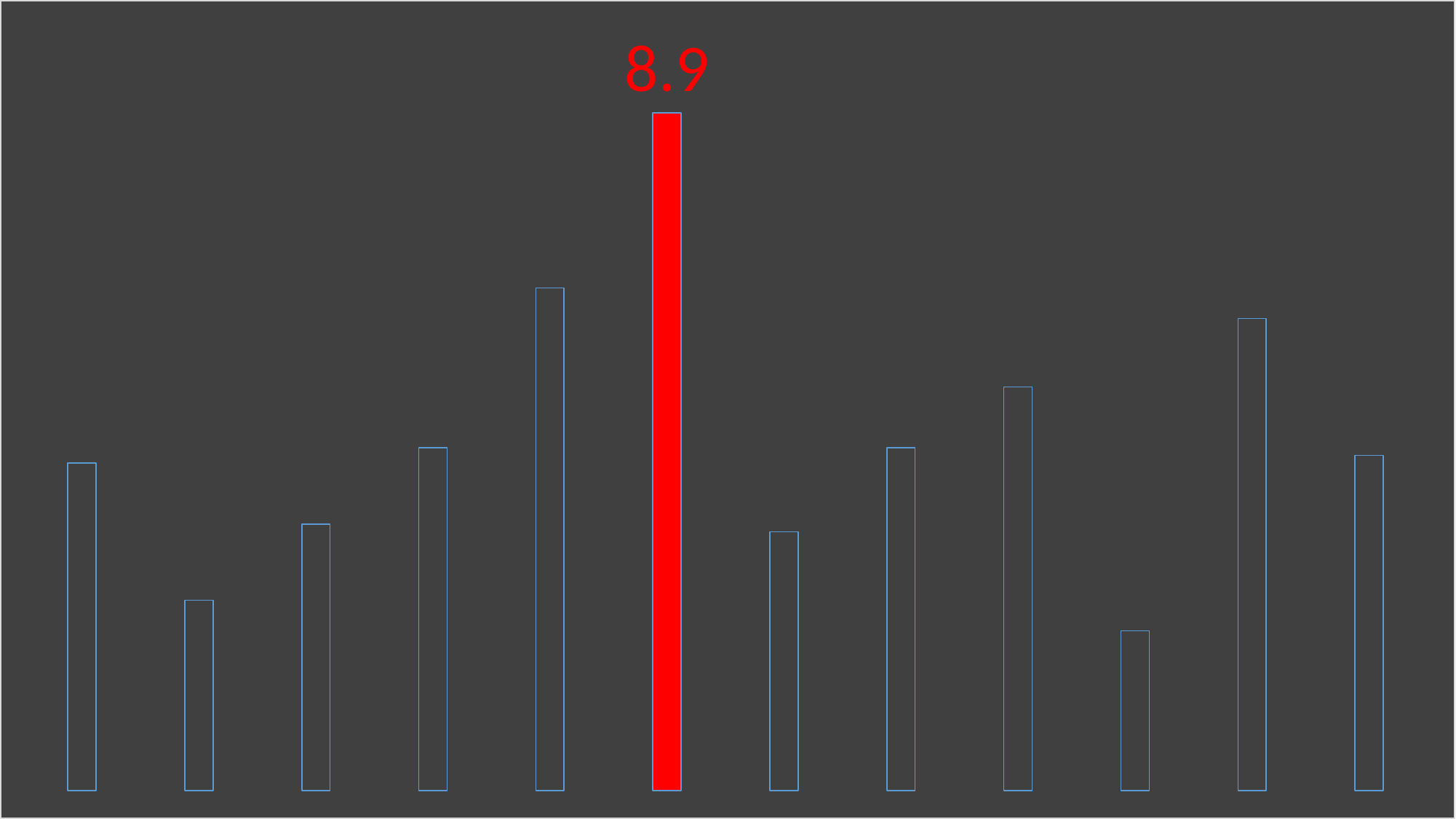
How many bars on the chart have a printed data label? 1 What kind of chart is shown on the slide? bar chart Which bar, counting from the left, is the tallest? the sixth bar How many bars does the chart contain? 12 What value is printed above the red highlighted bar? 8.9 What colour is the highlighted bar with the data label? red Which is taller, the eighth bar from the left or the ninth bar from the left? the ninth bar Which bar, counting from the left, is the shortest? the tenth bar Which is taller, the fifth bar from the left or the eleventh bar from the left? the fifth bar Which is taller, the second bar from the left or the seventh bar from the left? the seventh bar